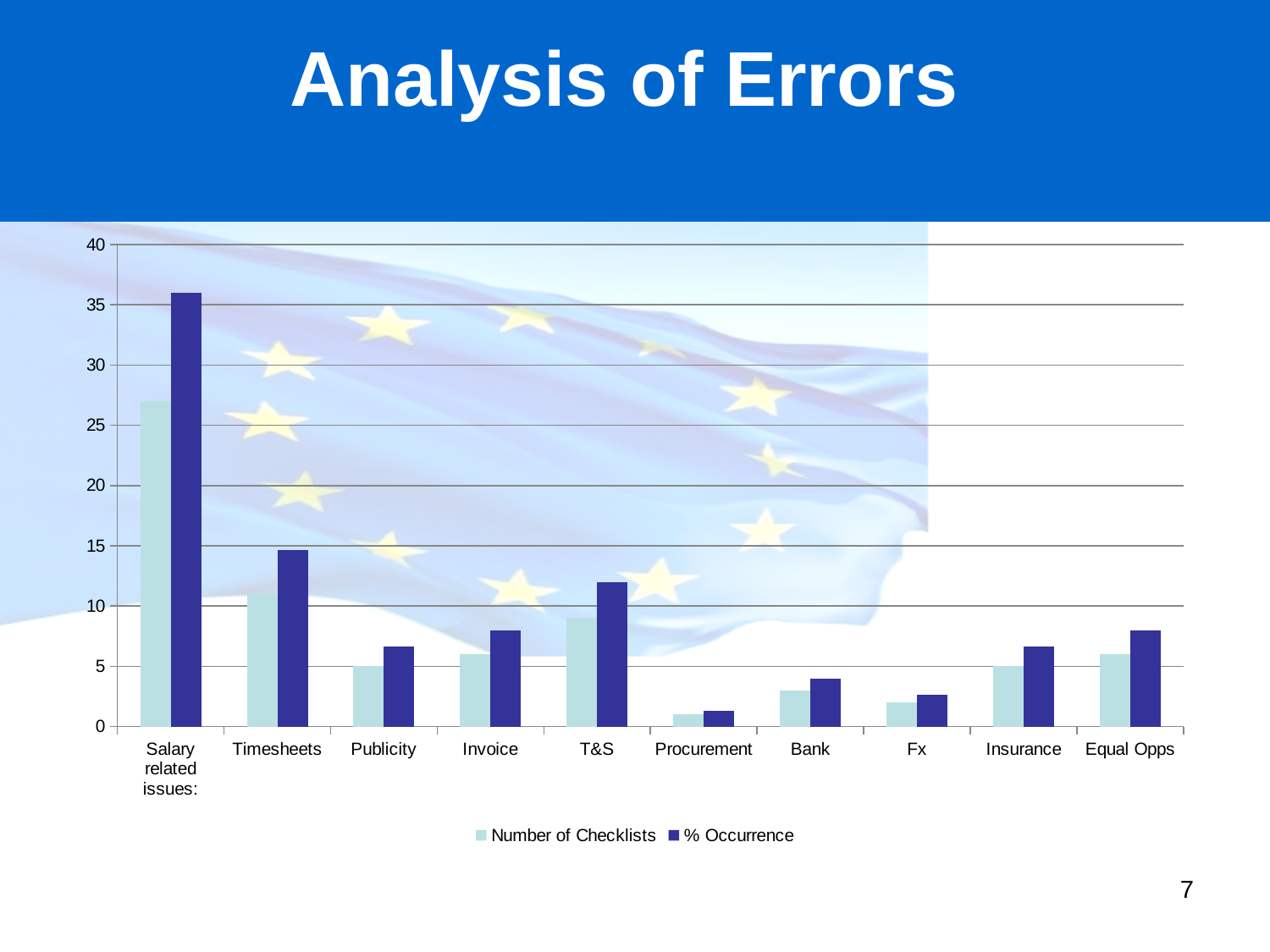
Which category has the lowest Number of Checklists? Procurement What is the title of the slide containing the chart? Analysis of Errors What kind of chart is shown on the slide? bar chart Is the Number of Checklists for Salary related issues greater or less than 25? greater Which is larger, the Number of Checklists for Timesheets or for T&S? Timesheets How many categories are shown on the x axis? 10 Is the % Occurrence for Salary related issues greater or less than 30? greater Which category has the lowest % Occurrence? Procurement Is the % Occurrence for T&S greater or less than 10? greater Which category has the highest Number of Checklists? Salary related issues: Which category has the highest % Occurrence? Salary related issues: How many series does the legend list? 2